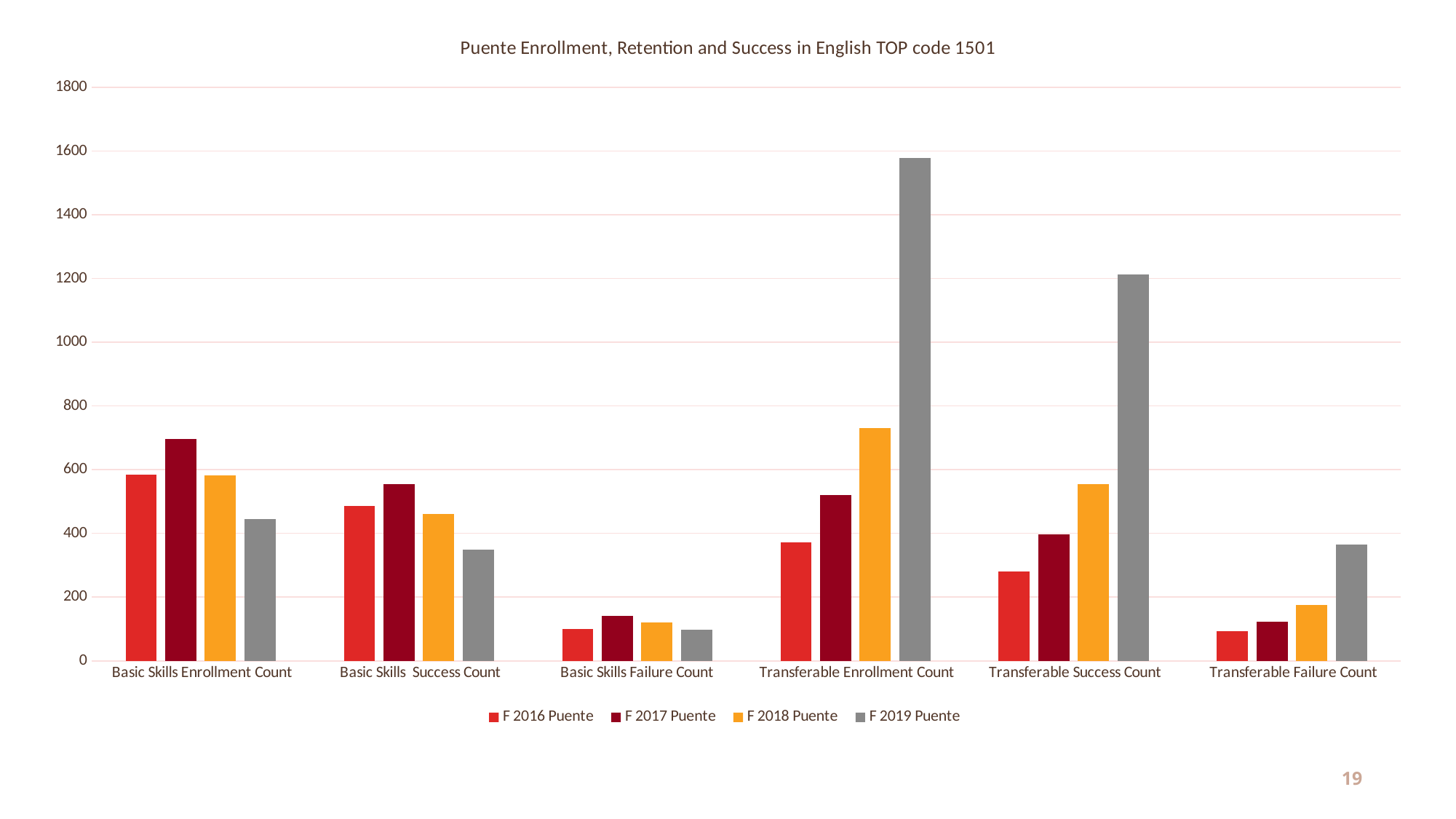
How many series does the legend list? 4 Which series has the lowest value for Transferable Enrollment Count? F 2016 Puente What kind of chart is shown on the slide? bar chart Is the F 2019 Puente value for Transferable Enrollment Count greater or less than 1400? greater Is the F 2019 Puente value for Transferable Success Count greater or less than 1000? greater Is the F 2018 Puente value for Transferable Enrollment Count greater or less than 600? greater For Basic Skills Enrollment Count, which is larger: the F 2017 Puente value or the F 2019 Puente value? F 2017 Puente How many categories are shown along the x axis? 6 For which category is the F 2019 Puente bar the highest? Transferable Enrollment Count Which series has the highest value for Basic Skills Enrollment Count? F 2017 Puente What is the title of the chart? Puente Enrollment, Retention and Success in English TOP code 1501